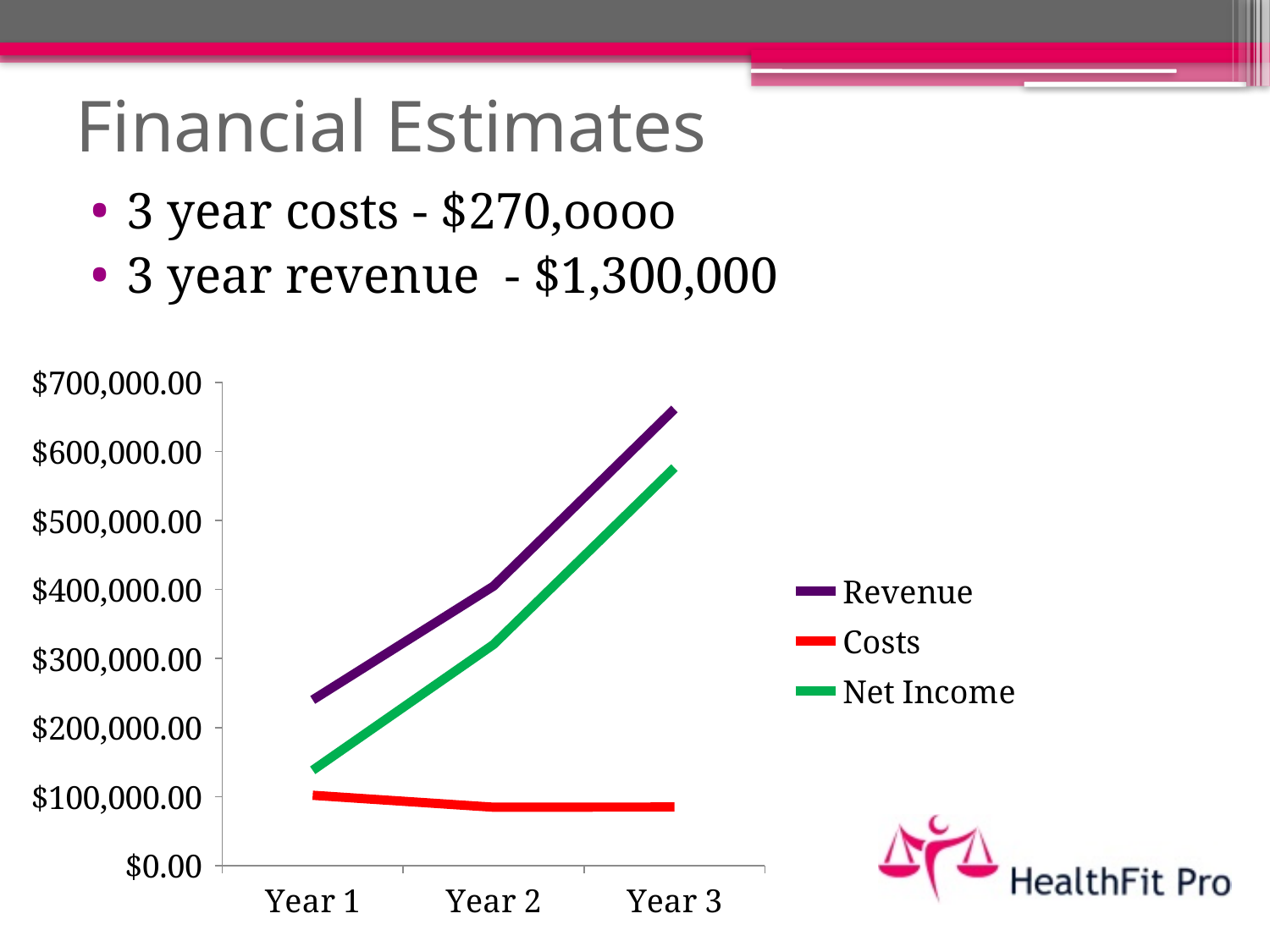
Does Net Income rise or fall from Year 1 to Year 3? Rises In which year is Net Income lowest? Year 1 What colour is the Costs line in the chart? Red In which year is Revenue highest? Year 3 How many years are plotted along the x axis of the chart? 3 Is Costs in Year 2 greater or less than $100,000.00? less Which series has the lowest values across all three years? Costs Which is larger in Year 2: Revenue or Net Income? Revenue Is Revenue in Year 3 greater or less than $600,000.00? greater Does Revenue rise or fall from Year 1 to Year 3? Rises What kind of chart is shown on the slide? Line chart How many series does the chart's legend list? 3